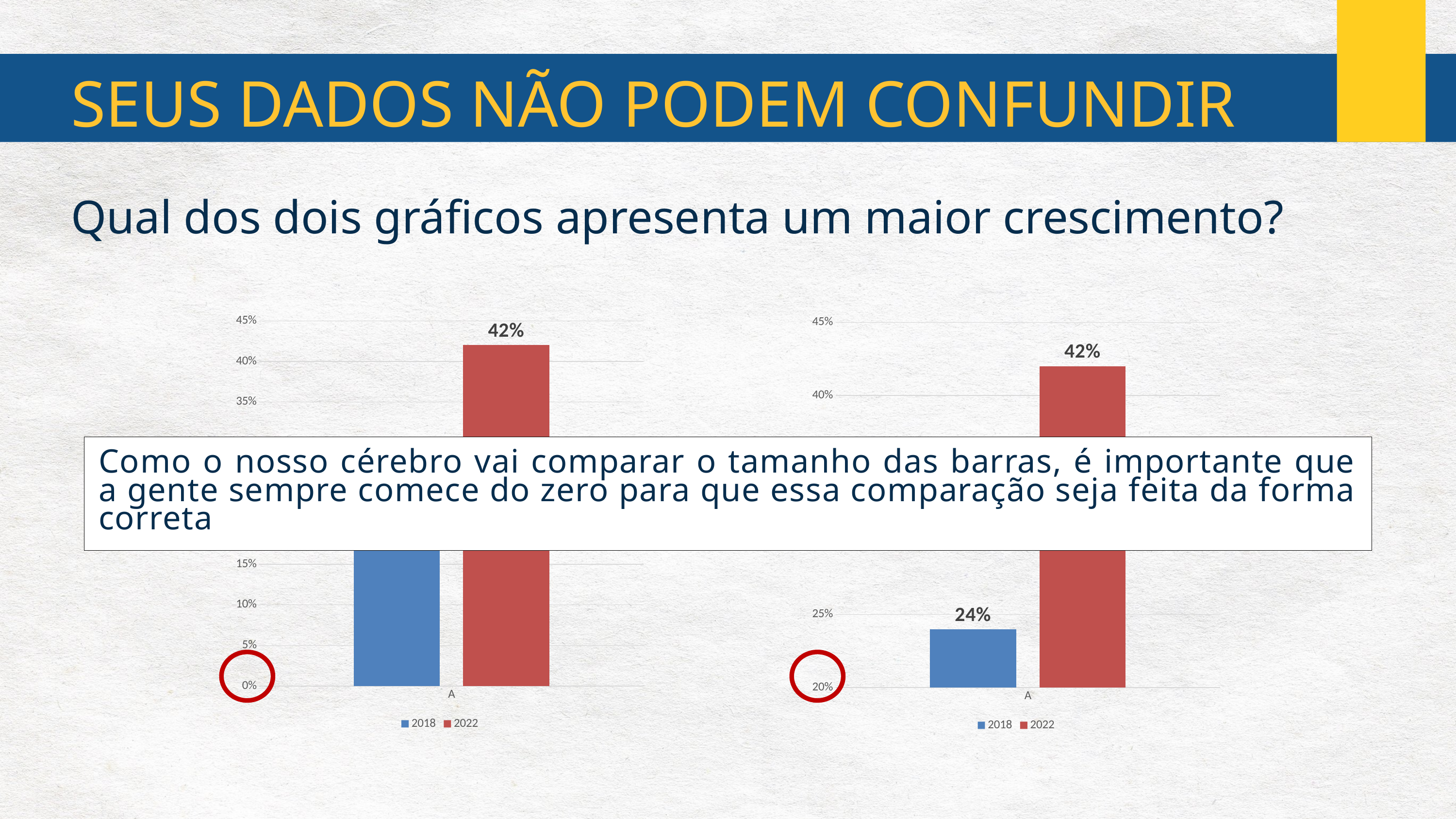
In the left chart, what is the value for 2022? 42% What kind of chart is the left chart? bar chart How many categories are shown on the x axis of the right chart? 1 In the right chart, what is the difference between the 2022 value and the 2018 value? 18% In the right chart, at what value does the y axis start? 20% How many series does the legend of the right chart list? 2 In the left chart, which series has the larger value, 2018 or 2022? 2022 In the left chart, is the value for 2018 greater or less than 15%? greater In the right chart, what is the value for 2022? 42% In the right chart, what is the value for 2018? 24% In the right chart, which series has the larger value, 2018 or 2022? 2022 In the left chart, at what value does the y axis start? 0%